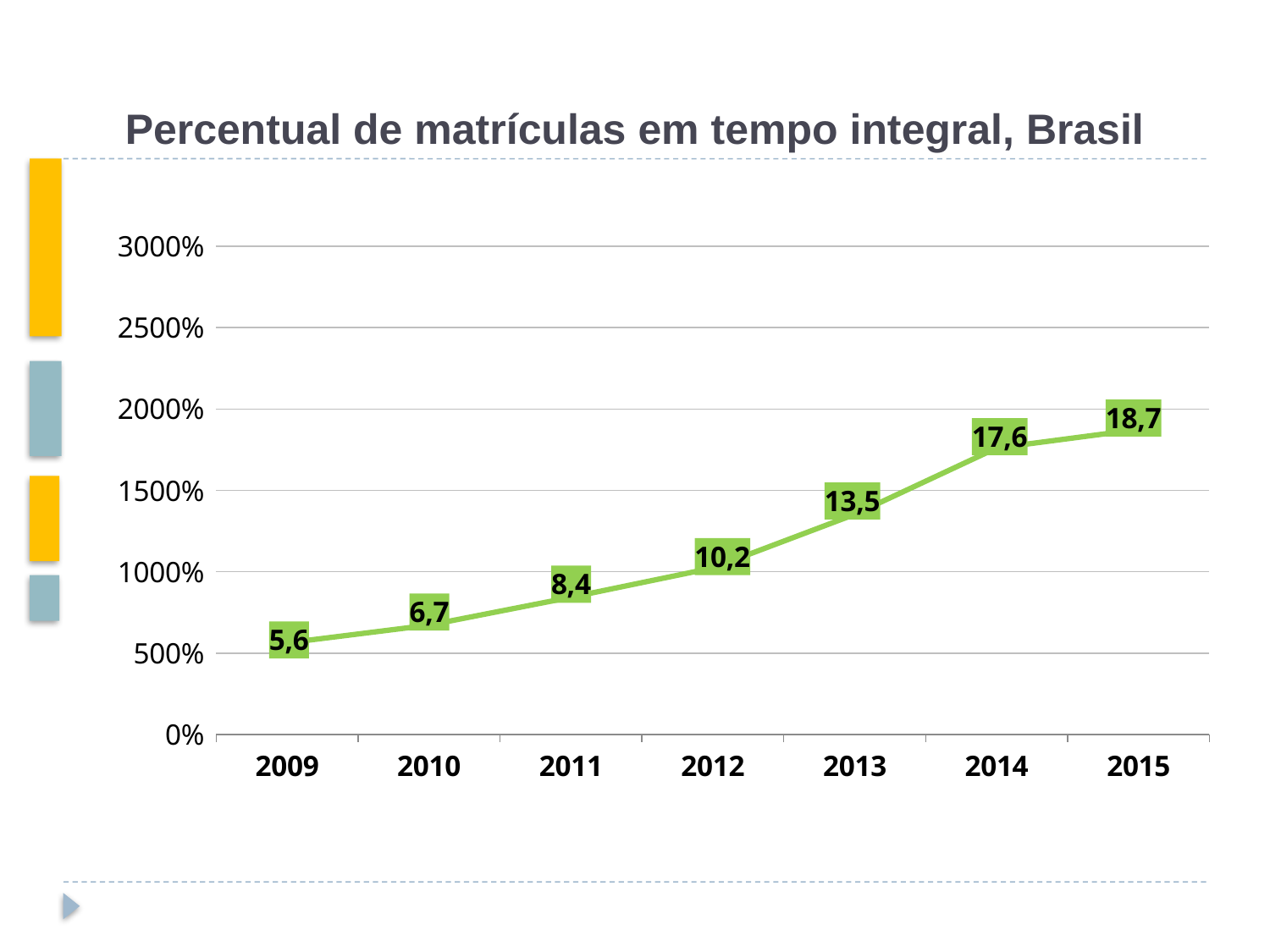
What is the value for 2009? 5,6 Do the values rise or fall from 2009 to 2015? rise What is the difference between the values for 2015 and 2009? 13,1 What is the value for 2015? 18,7 Which is larger, the value for 2011 or the value for 2012? 2012 How many years are plotted on the x axis? 7 What is the difference between the values for 2014 and 2013? 4,1 Which year has the highest value? 2015 What is the value for 2013? 13,5 Which year has the lowest value? 2009 What is the title of the chart? Percentual de matrículas em tempo integral, Brasil What kind of chart is shown? line chart